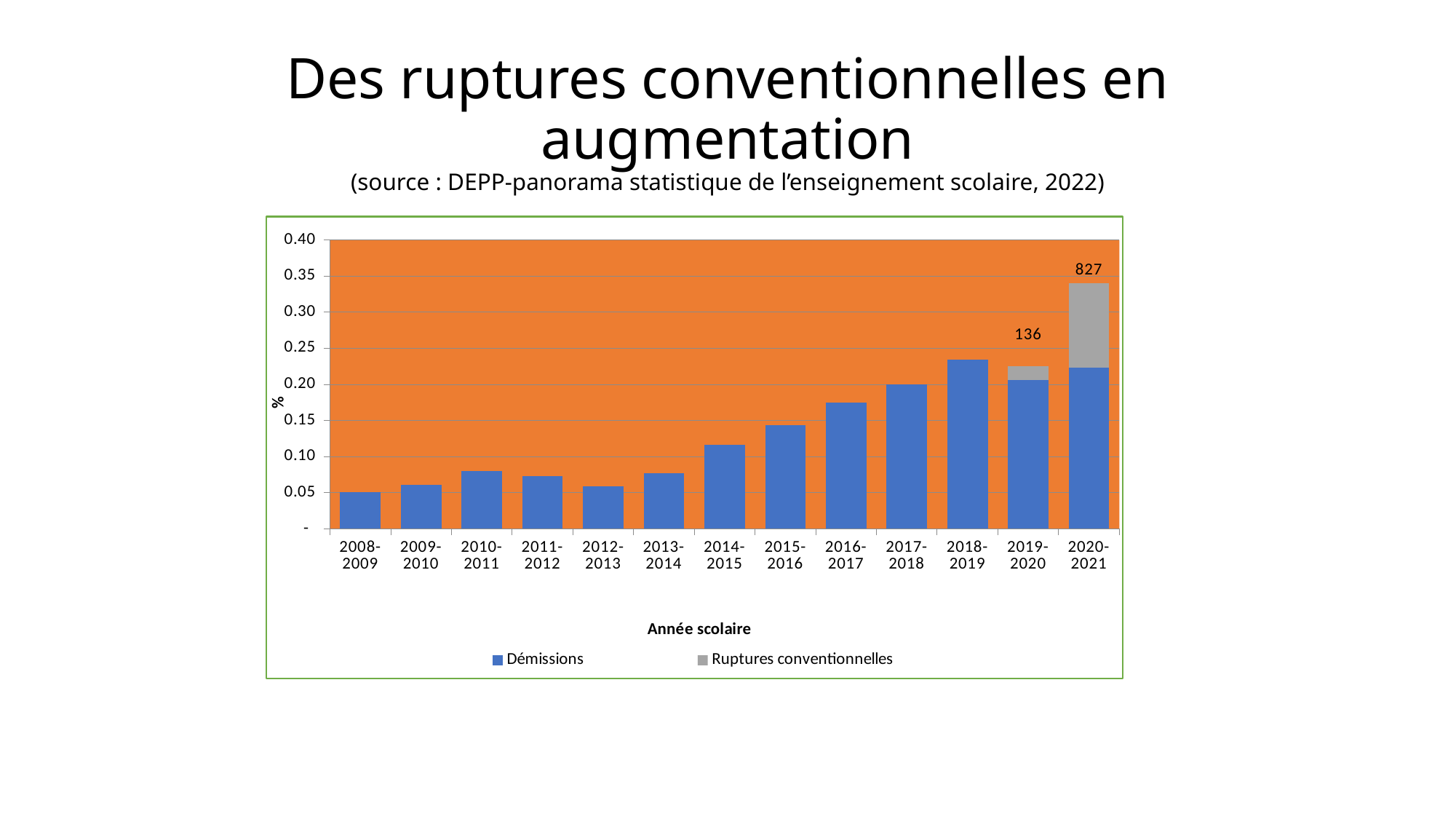
Which is larger, the Démissions value for 2013-2014 or for 2014-2015? 2014-2015 Do the Démissions values generally rise or fall from 2008-2009 to 2018-2019? rise Which school year has the tallest stacked bar overall? 2020-2021 Is the Démissions value for 2018-2019 greater or less than 0.20? greater What kind of chart is shown on the slide? bar chart Is the Démissions value for 2016-2017 greater or less than 0.20? less Which school year has the lowest Démissions value? 2008-2009 How many school years are shown on the x axis of the chart? 13 What data label is printed above the Ruptures conventionnelles segment for 2020-2021? 827 Is the Démissions value for 2014-2015 greater or less than 0.10? greater How many series does the chart legend list? 2 What data label is printed above the Ruptures conventionnelles segment for 2019-2020? 136